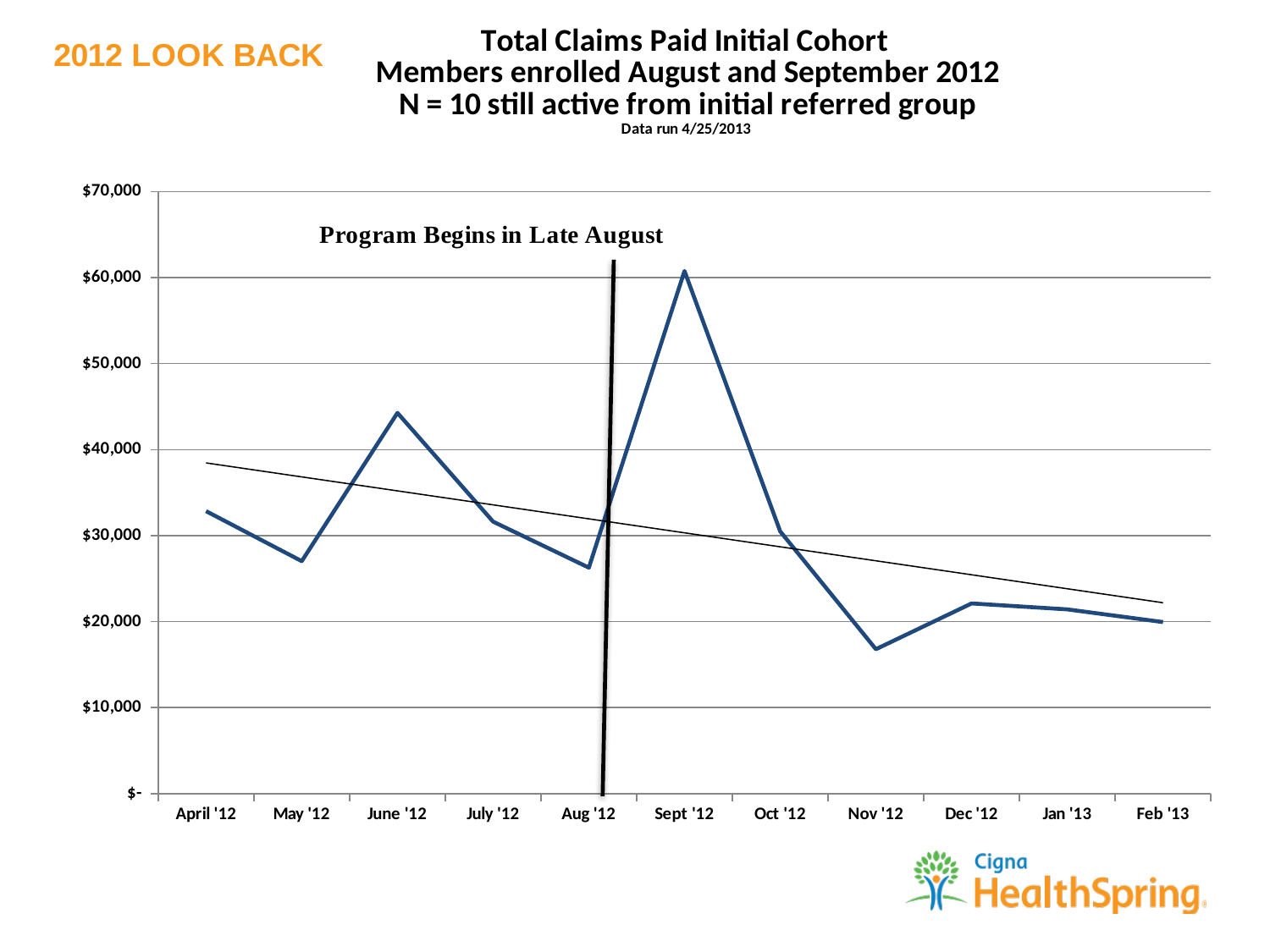
According to the thin trend line, do total claims paid rise or fall from April '12 to Feb '13? fall Which month has the lowest total claims paid? Nov '12 Is the value for Nov '12 greater or less than $20,000? less Is the value for Aug '12 greater or less than $30,000? less Which is larger, the value for Sept '12 or the value for Oct '12? Sept '12 What does the annotation next to the vertical black line say? Program Begins in Late August Is the value for June '12 greater or less than $40,000? greater What kind of chart is shown on the slide? line chart Which month has the highest total claims paid? Sept '12 Which is larger, the value for June '12 or the value for May '12? June '12 How many months are plotted along the x axis? 11